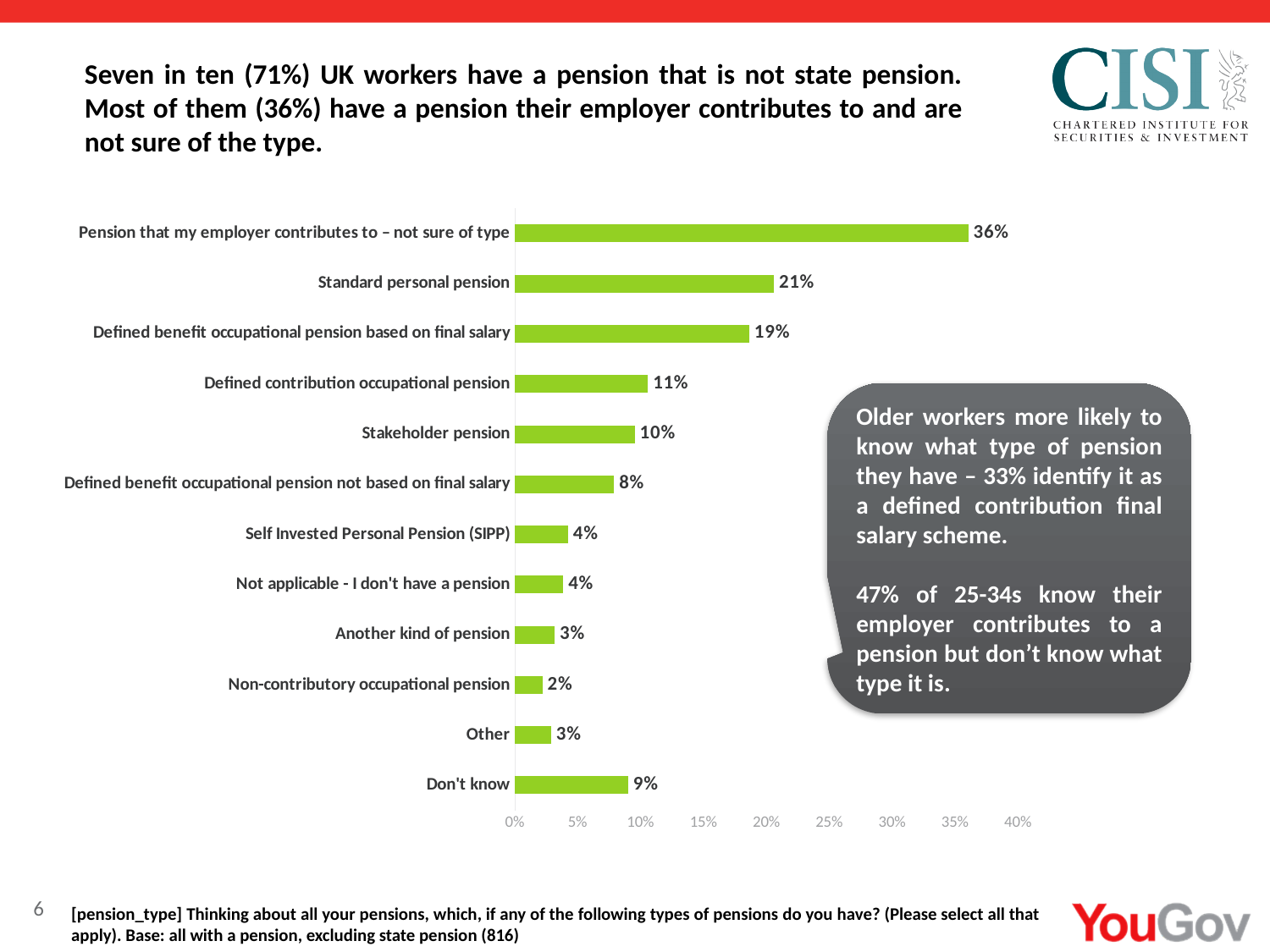
What percentage of respondents have a Self Invested Personal Pension (SIPP)? 4% Which category has the highest value? Pension that my employer contributes to – not sure of type What is the value for Standard personal pension? 21% What kind of chart is shown on the slide? Bar chart What is the difference between the highest value and the value for Stakeholder pension? 26% What percentage of respondents have a pension that their employer contributes to but are not sure of the type? 36% Which category has the lowest value? Non-contributory occupational pension How many categories are shown in the chart? 12 What is the value for Don't know? 9% What is the difference between Standard personal pension and Defined benefit occupational pension based on final salary? 2% What is the highest value shown on the x axis? 40% Which is larger: Defined contribution occupational pension or Stakeholder pension? Defined contribution occupational pension